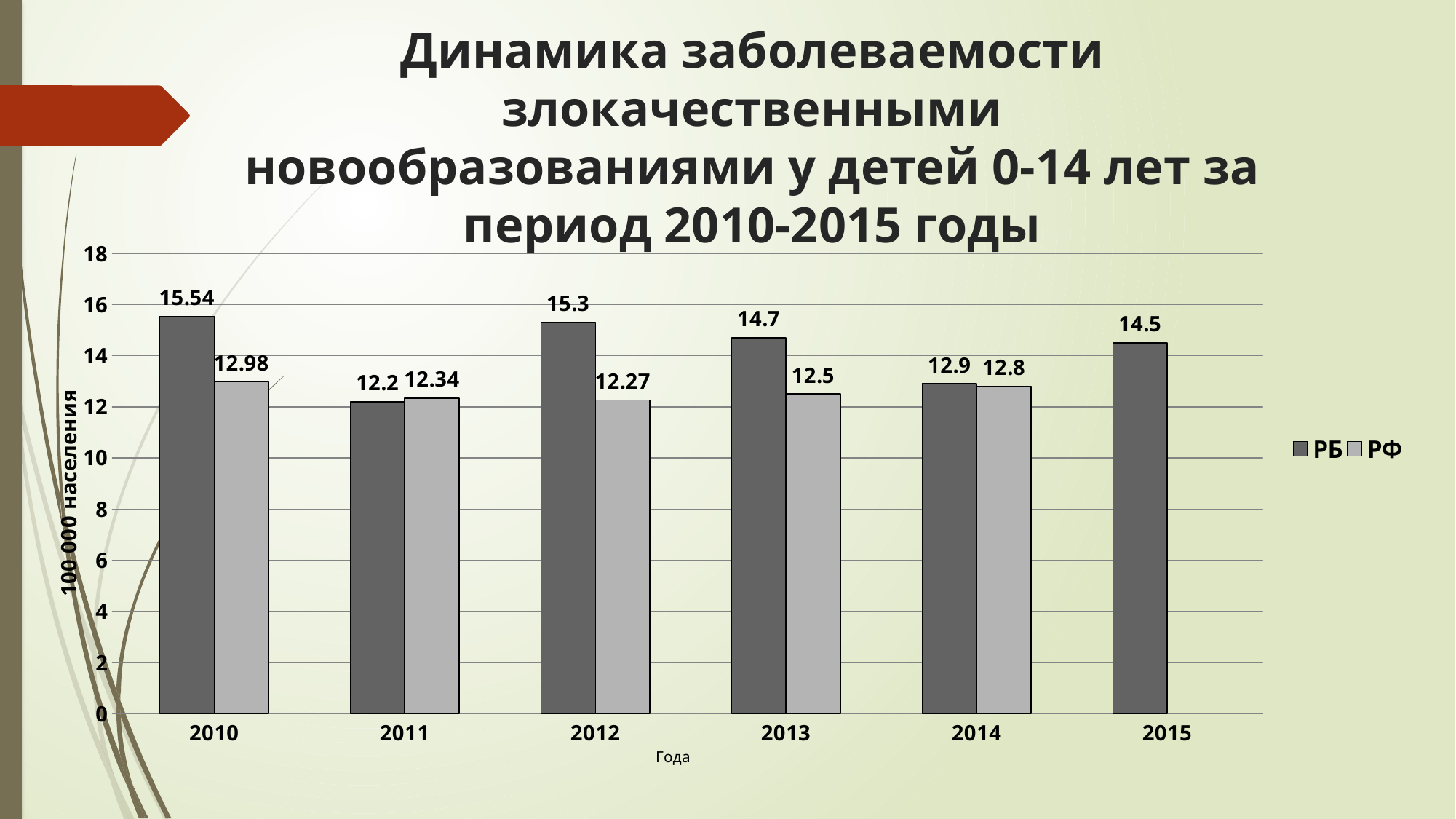
What is the value for РБ in 2010? 15.54 Is the value for РБ in 2013 greater or less than 14? greater In which year is the РФ value lowest? 2012 What is the value for РБ in 2015? 14.5 In which year is the РБ value highest? 2010 How many series does the legend list? 2 What is the value for РФ in 2013? 12.5 How many years are shown on the x axis? 6 In which year is the РБ value lowest? 2011 Which is larger in 2011, the РБ value or the РФ value? РФ What kind of chart is shown on the slide? bar chart What is the difference between the РБ and РФ values in 2012? 3.03